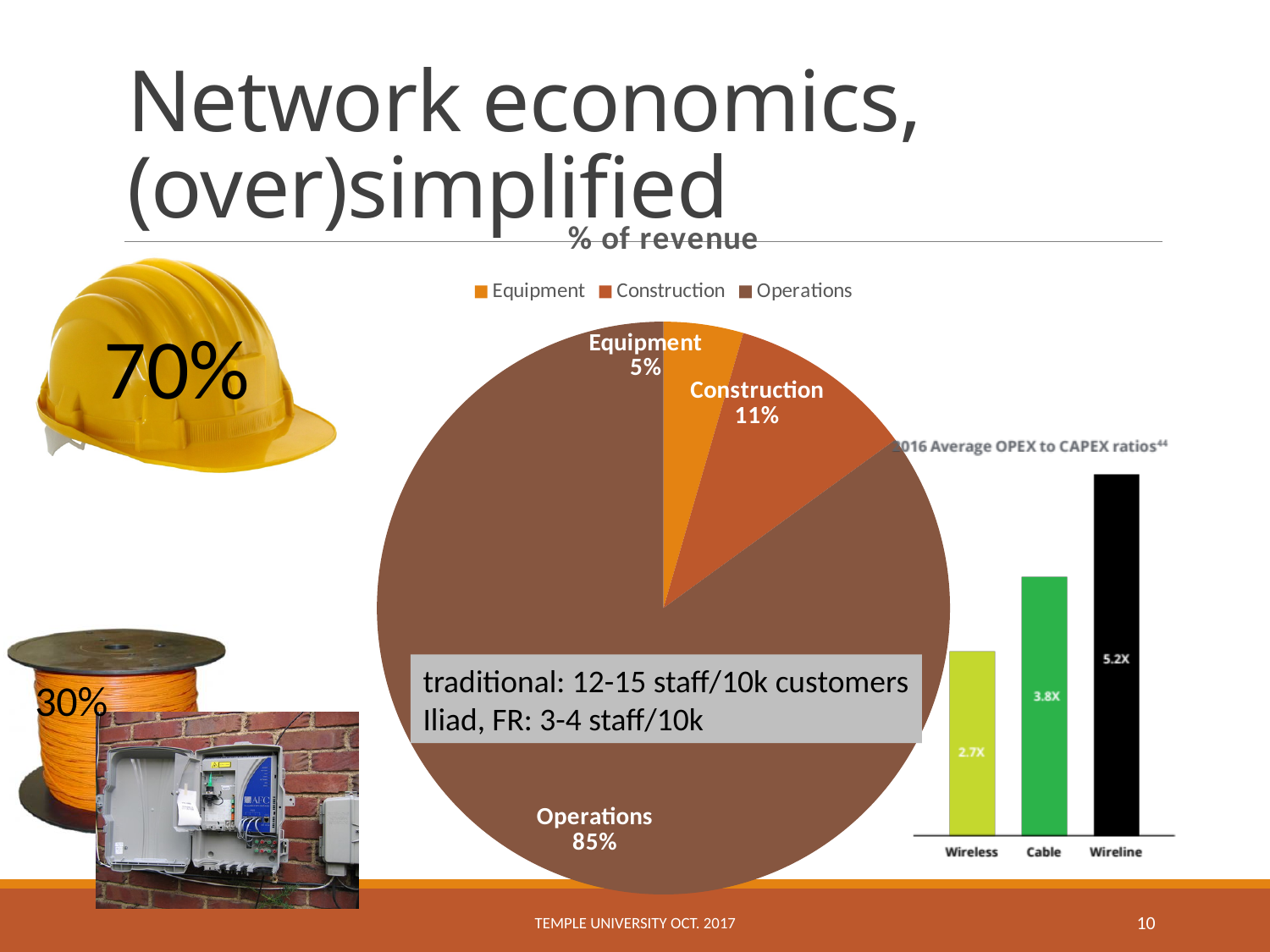
In the '% of revenue' pie chart, what is the difference in percentage points between Construction and Equipment? 6 In the '2016 Average OPEX to CAPEX ratios' chart, which category has the lowest ratio? Wireless What kind of chart is the '% of revenue' chart? pie chart In the '% of revenue' pie chart, how many slices are there? 3 In the '% of revenue' pie chart, what share does Operations have? 85% In the '% of revenue' pie chart, which slice is the largest? Operations What kind of chart is the '2016 Average OPEX to CAPEX ratios' chart? bar chart In the '2016 Average OPEX to CAPEX ratios' chart, what is the value for Wireline? 5.2X In the '% of revenue' pie chart, which slice is the smallest? Equipment In the '% of revenue' pie chart, what share does Equipment have? 5% In the '% of revenue' pie chart, what share does Construction have? 11% In the '2016 Average OPEX to CAPEX ratios' chart, what is the value for Wireless? 2.7X